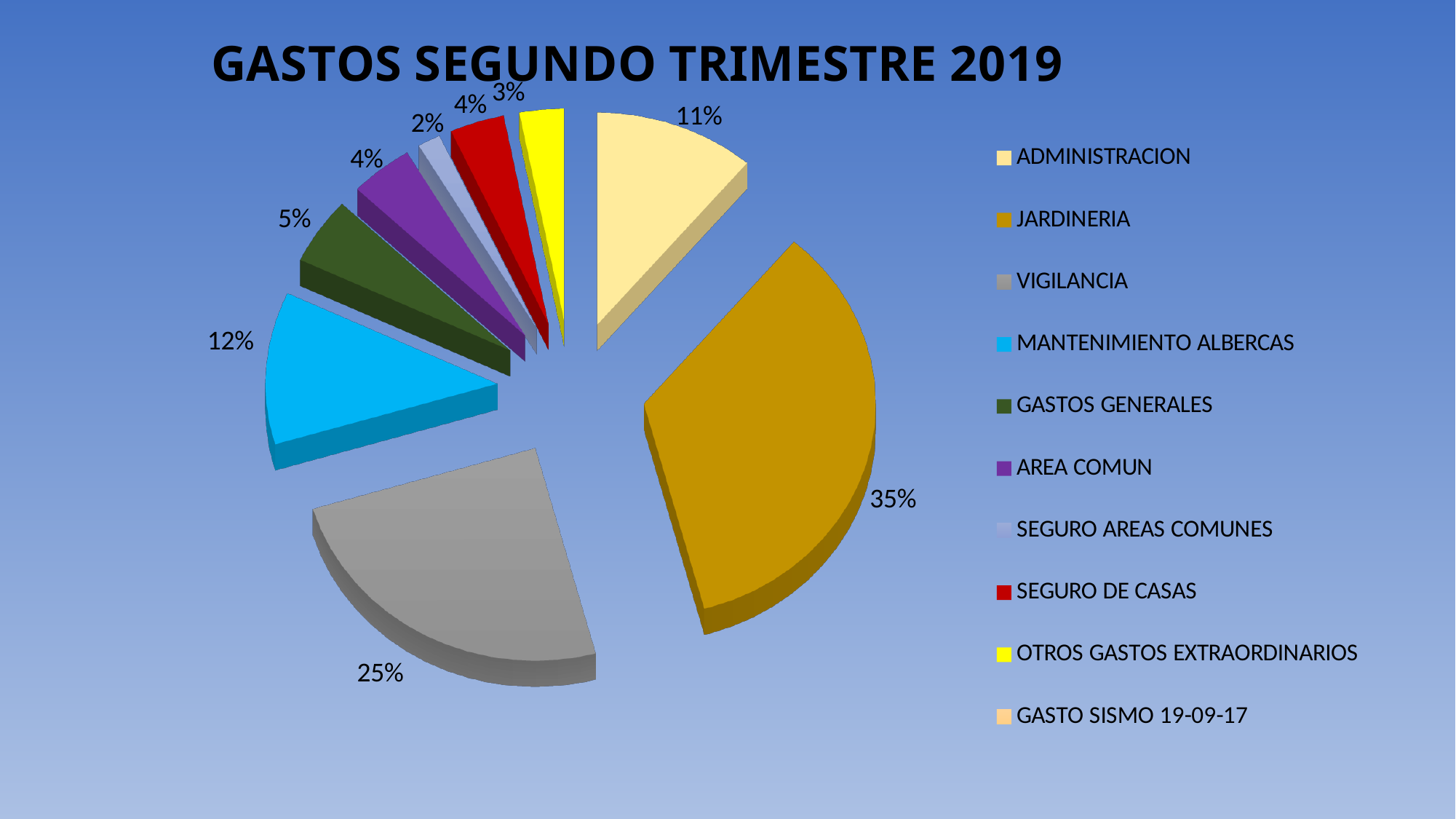
What is the difference in percentage points between JARDINERIA and VIGILANCIA? 10 What percentage is shown for SEGURO AREAS COMUNES? 2% What is the title of the chart? GASTOS SEGUNDO TRIMESTRE 2019 What percentage is shown for MANTENIMIENTO ALBERCAS? 12% What share of the pie does VIGILANCIA represent? 25% Which is larger, the share for MANTENIMIENTO ALBERCAS or the share for ADMINISTRACION? MANTENIMIENTO ALBERCAS Which category has the largest share of the pie? JARDINERIA What percentage is shown for ADMINISTRACION? 11% How many entries does the legend list? 10 What percentage is shown for GASTOS GENERALES? 5% What type of chart is shown on the slide? Pie chart What share of the pie does JARDINERIA represent? 35%